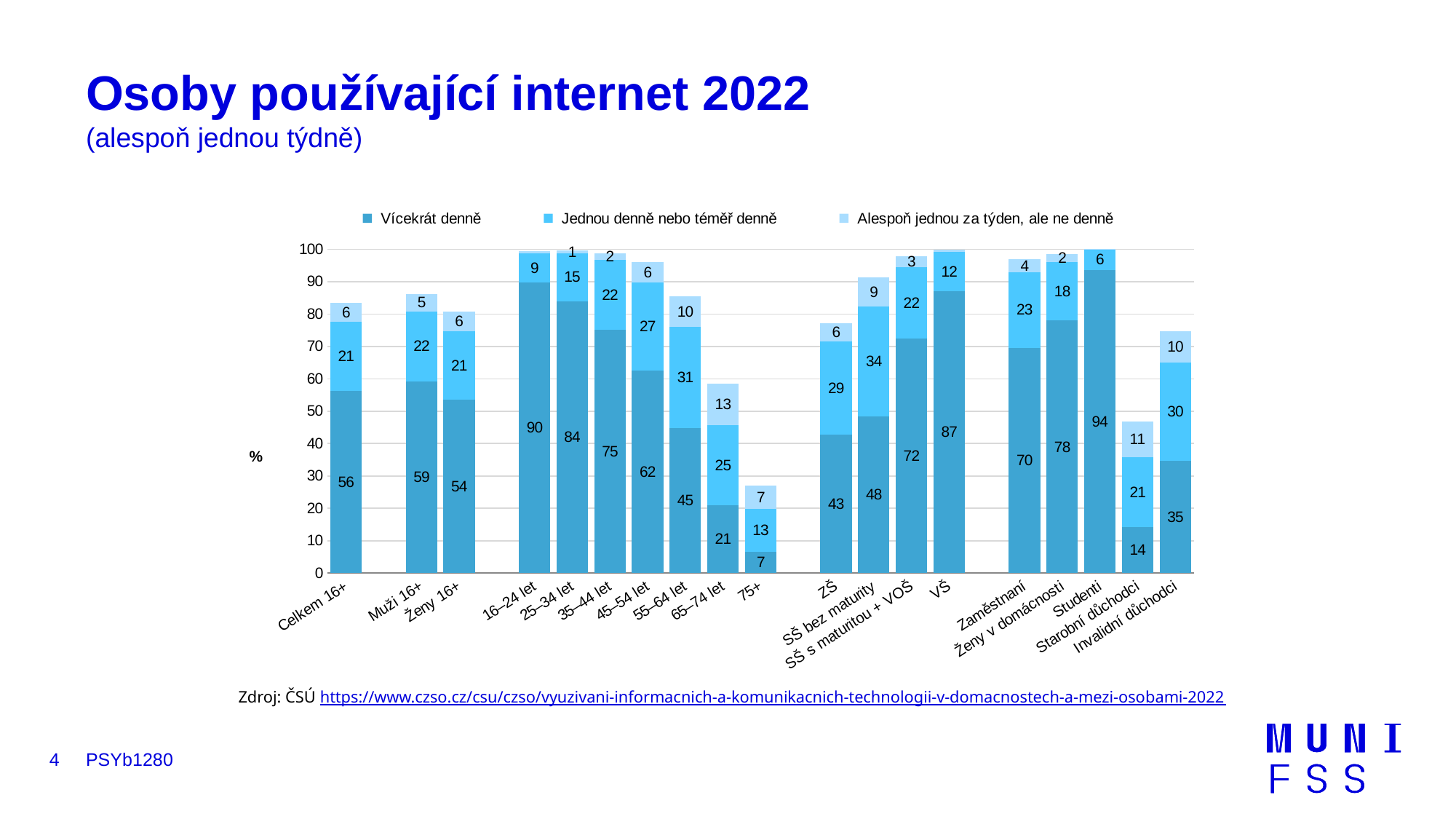
What is the value of "Vícekrát denně" for Studenti? 94 Which category has the lowest value for "Vícekrát denně"? 75+ What is the value of "Jednou denně nebo téměř denně" for 55–64 let? 31 Which category has the highest value for "Vícekrát denně"? Studenti How many categories are shown on the x axis? 19 What is the difference between the "Vícekrát denně" values for Muži 16+ and Ženy 16+? 5 What kind of chart is shown on the slide? stacked bar chart How many series does the legend list? 3 What is the value of "Alespoň jednou za týden, ale ne denně" for Starobní důchodci? 11 Which is larger, the "Jednou denně nebo téměř denně" value for SŠ bez maturity or for ZŠ? SŠ bez maturity What is the total of the stacked bar for 75+? 27 What is the total of the stacked bar for Celkem 16+? 83